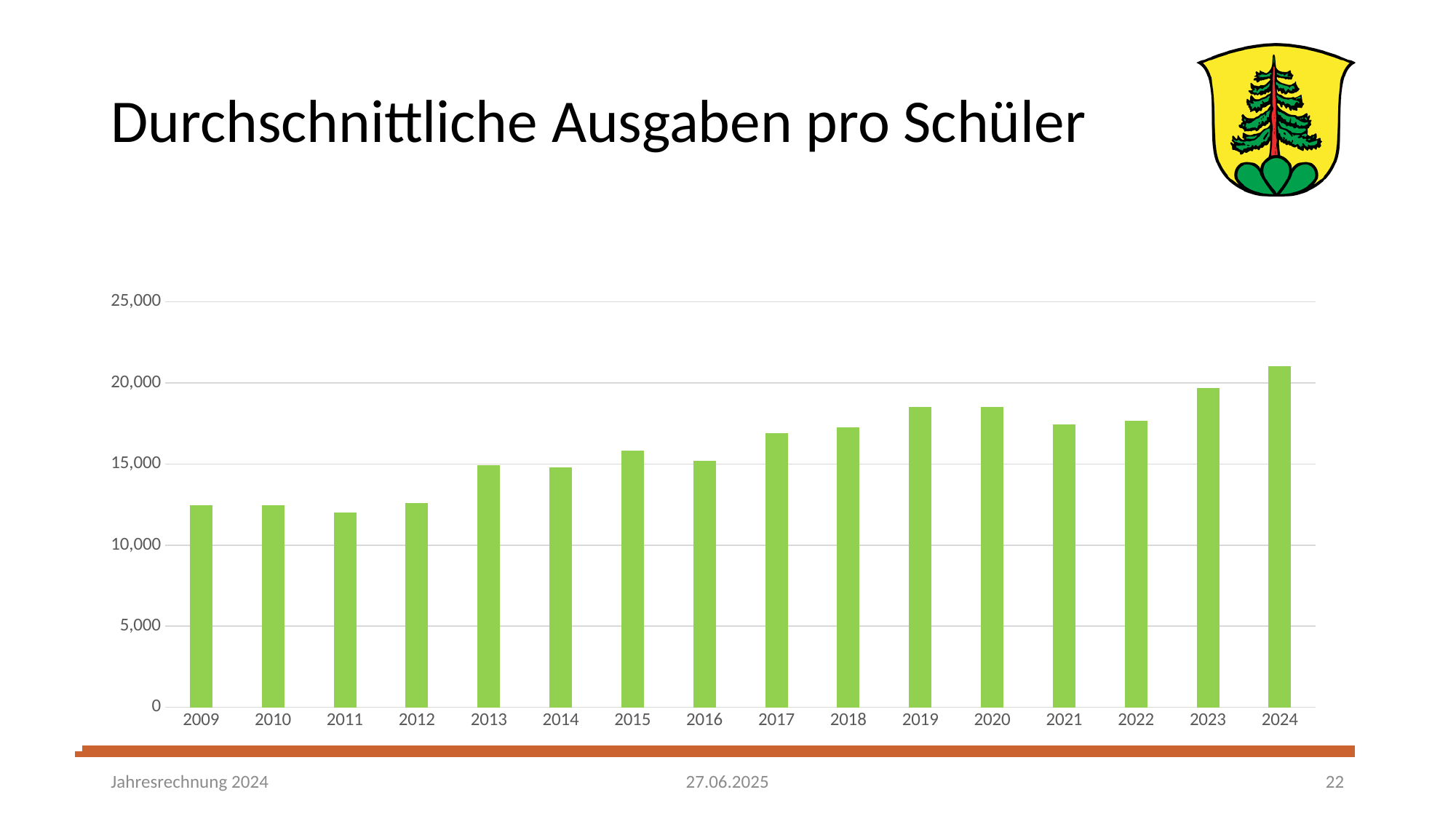
How many years are shown on the x axis of the chart? 16 Is the value for 2011 greater or less than 15,000? less Is the value for 2024 greater or less than 20,000? greater Is the value for 2017 greater or less than 15,000? greater Which year has the larger value, 2015 or 2016? 2015 Which year has the highest value in the chart? 2024 Which year has the lowest value in the chart? 2011 Which year has the larger value, 2019 or 2021? 2019 What is the title of the chart? Durchschnittliche Ausgaben pro Schüler What kind of chart is shown on the slide? bar chart Do the values generally rise or fall from 2009 to 2024? rise